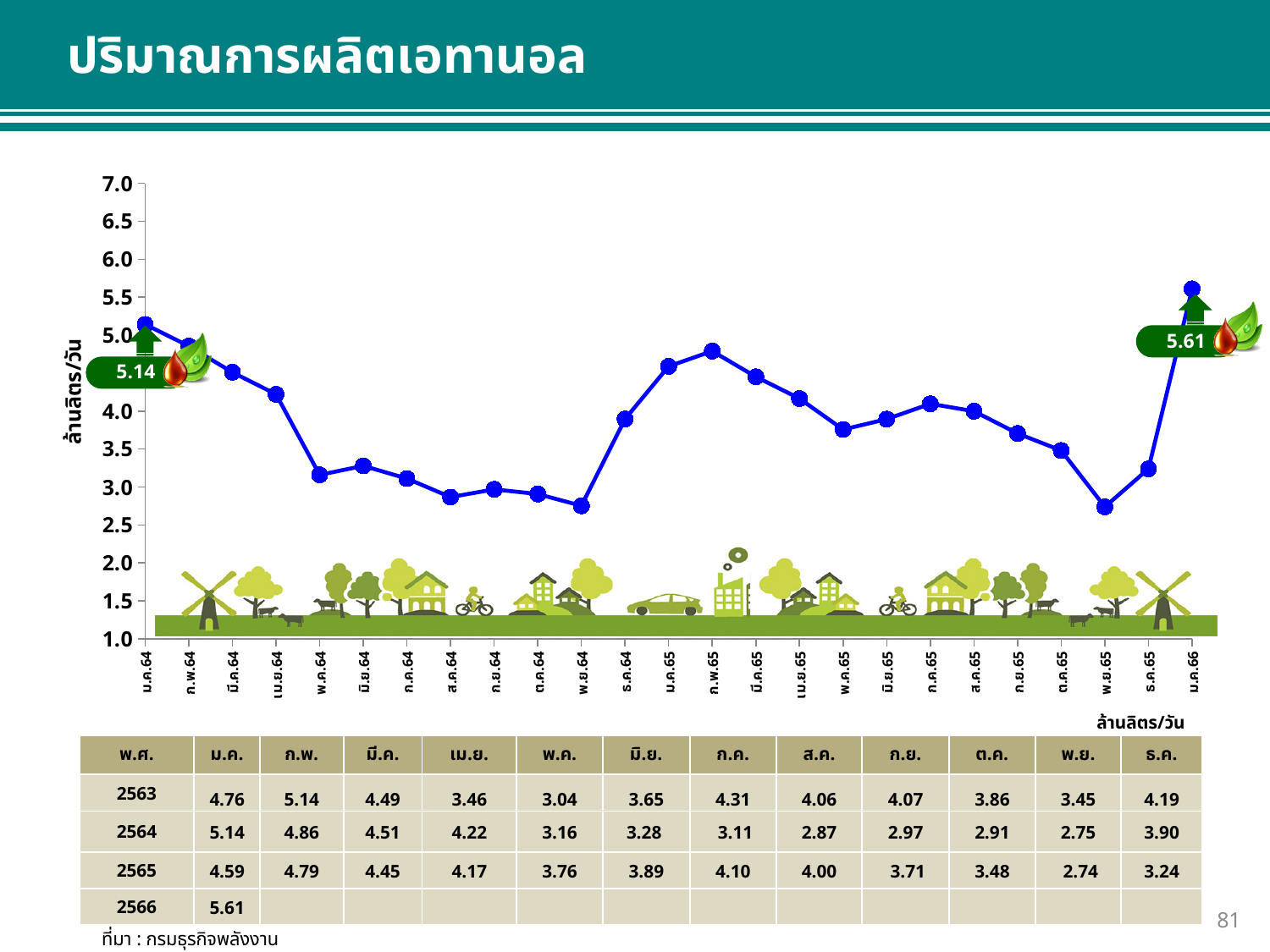
Is the value for พ.ย.64 greater or less than 3.0? less What is the title of the slide's chart? ปริมาณการผลิตเอทานอล Is the value for ม.ค.65 greater or less than 4.0? greater What is the difference between the labelled values for ม.ค.66 and ม.ค.64? 0.47 Which is larger, the value for ม.ค.66 or the value for ม.ค.64? ม.ค.66 What is the ethanol production value labelled for ม.ค.66? 5.61 Which month has the highest point on the line chart? ม.ค.66 What is the label on the vertical axis of the chart? ล้านลิตร/วัน Does the line rise or fall from ม.ค.64 to พ.ย.64? fall What kind of chart is shown on the slide? line chart How many data points are plotted on the line chart? 25 What is the ethanol production value labelled for ม.ค.64? 5.14